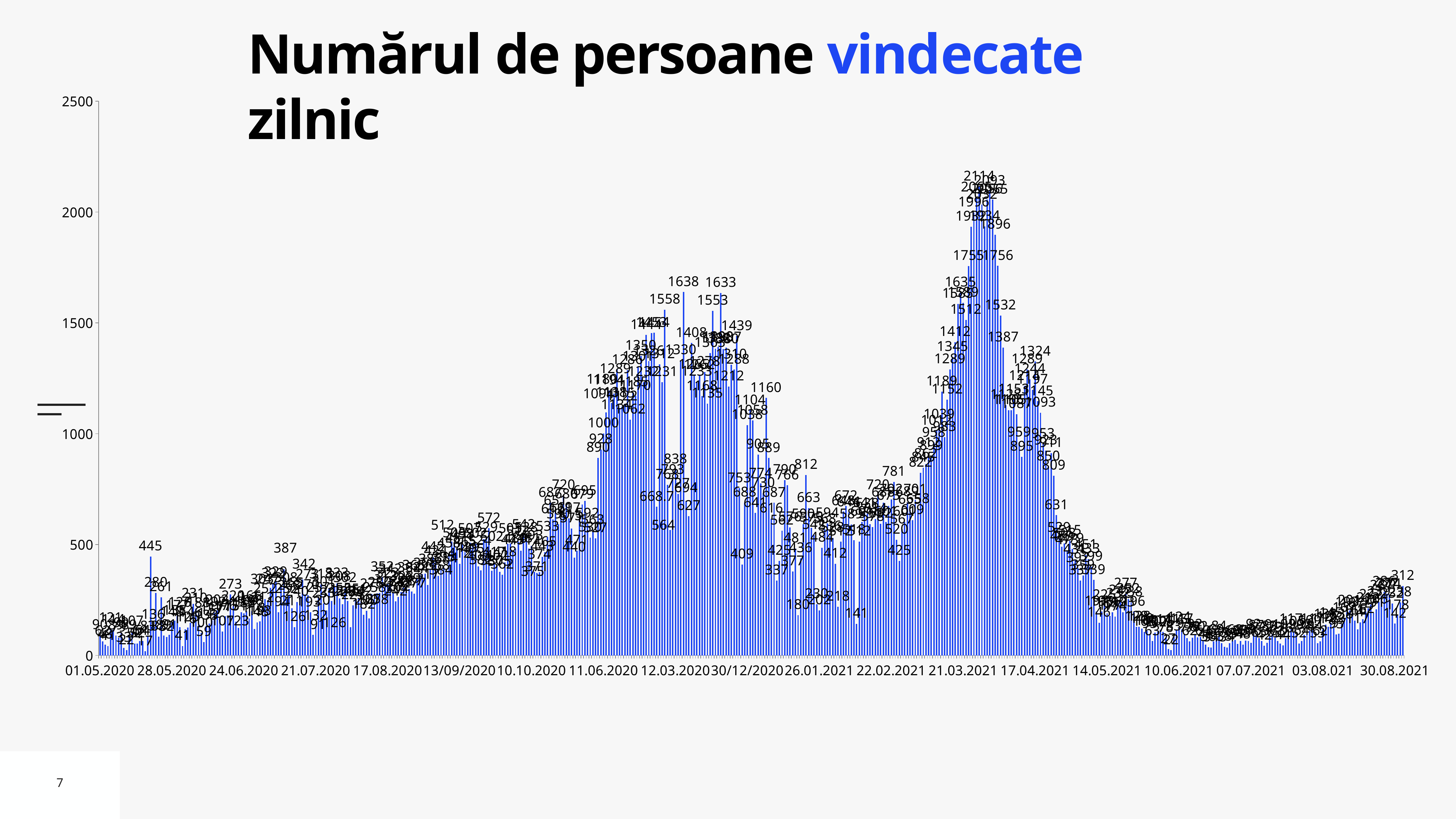
What is the title of the chart? Numărul de persoane vindecate zilnic Is the value for 01.05.2020 greater or less than 500? less Which is larger: the spike labelled near 28.05.2020 or the spike labelled near 21.07.2020? the spike near 28.05.2020 (445) Is the highest bar on the chart greater or less than 2000? greater Do the values rise or fall along the x axis between 17.04.2021 and 10.06.2021? fall What is the difference between the spike labelled 445 and the spike labelled 387? 58 What kind of chart is shown on the slide? bar chart What is the value of the spike labelled just before the 21.07.2020 tick? 387 What is the value of the isolated spike labelled just before the 28.05.2020 tick? 445 What is the highest daily value labelled on the chart? 2114 What is the highest tick value shown on the vertical axis? 2500 Do the values rise or fall along the x axis between 03.08.2021 and 30.08.2021? rise